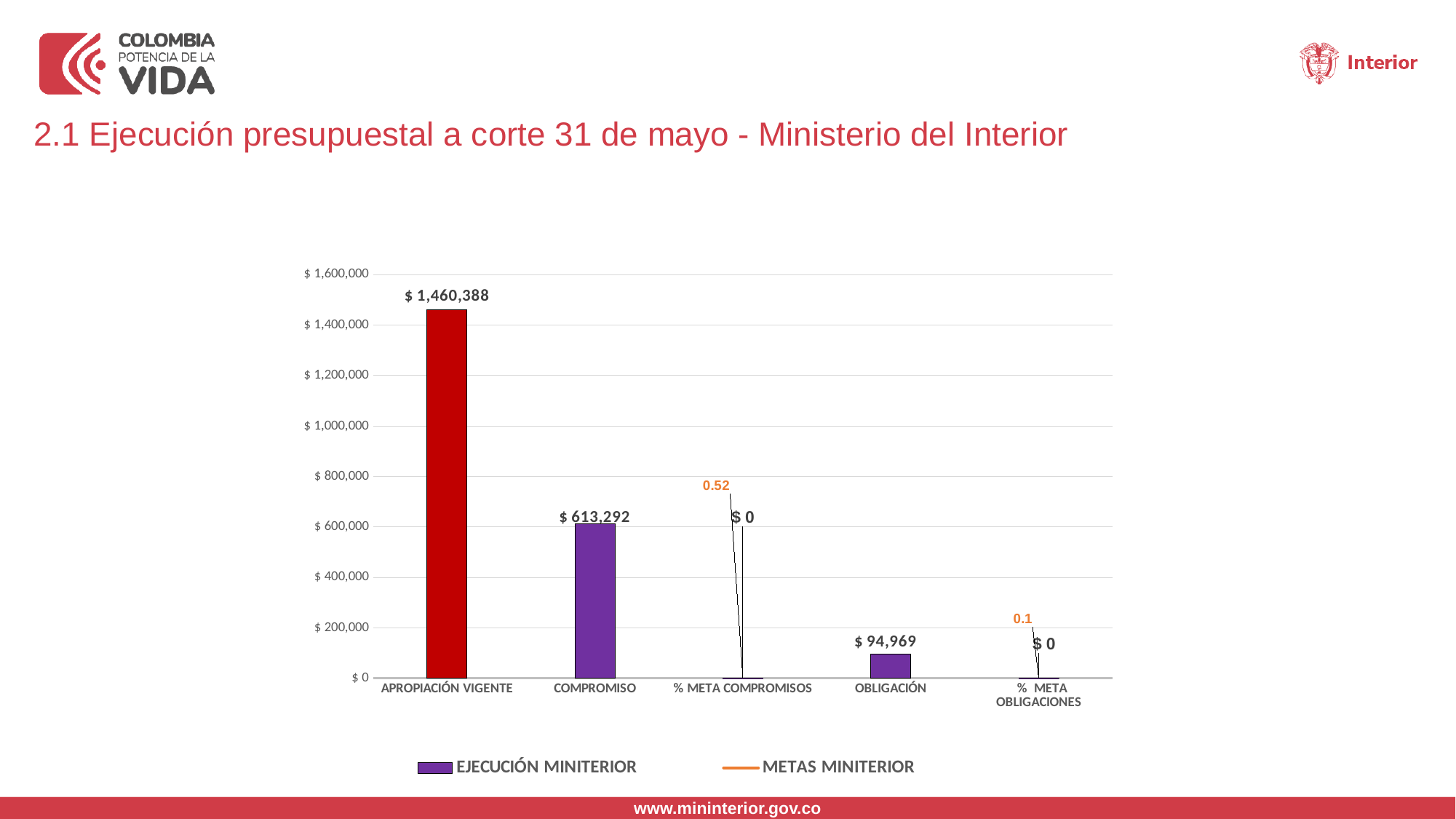
What is the value for COMPROMISO? $ 613,292 What is the METAS MINITERIOR value shown for % META OBLIGACIONES? 0.1 Which category has the highest value? APROPIACIÓN VIGENTE How many categories are shown on the x axis? 5 What kind of chart is shown on the slide? Combination bar and line chart What is the EJECUCIÓN MINITERIOR value shown for % META COMPROMISOS? $ 0 What is the value for APROPIACIÓN VIGENTE? $ 1,460,388 Which is larger, COMPROMISO or OBLIGACIÓN? COMPROMISO How many series does the legend list? 2 What is the difference between APROPIACIÓN VIGENTE and COMPROMISO? $ 847,096 What is the METAS MINITERIOR value shown for % META COMPROMISOS? 0.52 What is the value for OBLIGACIÓN? $ 94,969